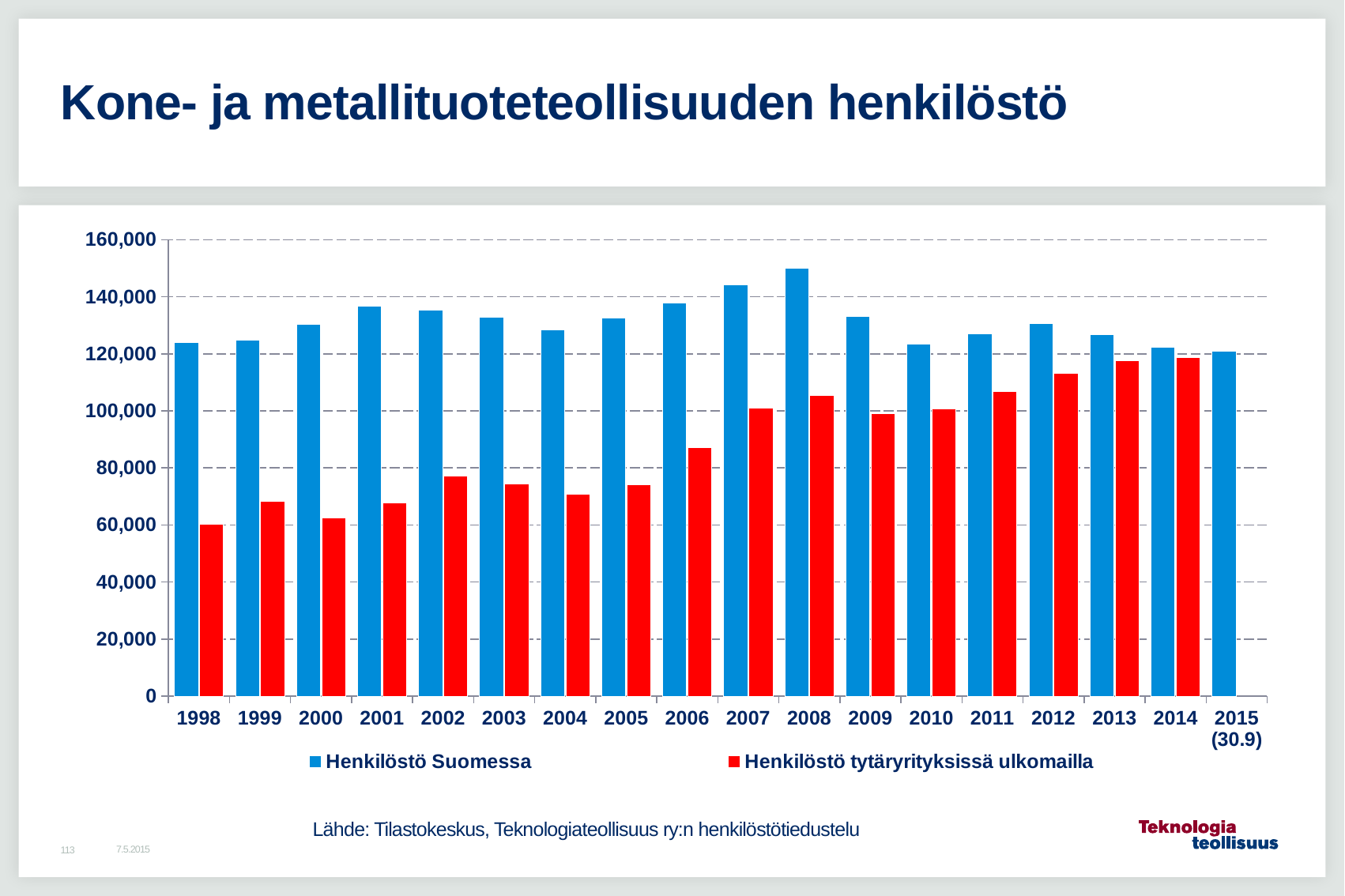
How many year categories are shown on the x axis? 18 Which is larger in 2014: Henkilöstö Suomessa or Henkilöstö tytäryrityksissä ulkomailla? Henkilöstö Suomessa How many series does the legend list? 2 In which year is the value for Henkilöstö tytäryrityksissä ulkomailla lowest? 1998 In which year is the value for Henkilöstö Suomessa highest? 2008 Is the value for Henkilöstö tytäryrityksissä ulkomailla in 2006 greater or less than 80,000? greater Does the value for Henkilöstö tytäryrityksissä ulkomailla generally rise or fall from 1998 to 2014? rise What is the title of the slide? Kone- ja metallituoteteollisuuden henkilöstö Is the value for Henkilöstö tytäryrityksissä ulkomailla in 2000 greater or less than 80,000? less What kind of chart is shown on the slide? bar chart Which colour represents Henkilöstö tytäryrityksissä ulkomailla in the chart? red Is the value for Henkilöstö Suomessa in 2008 greater or less than 140,000? greater